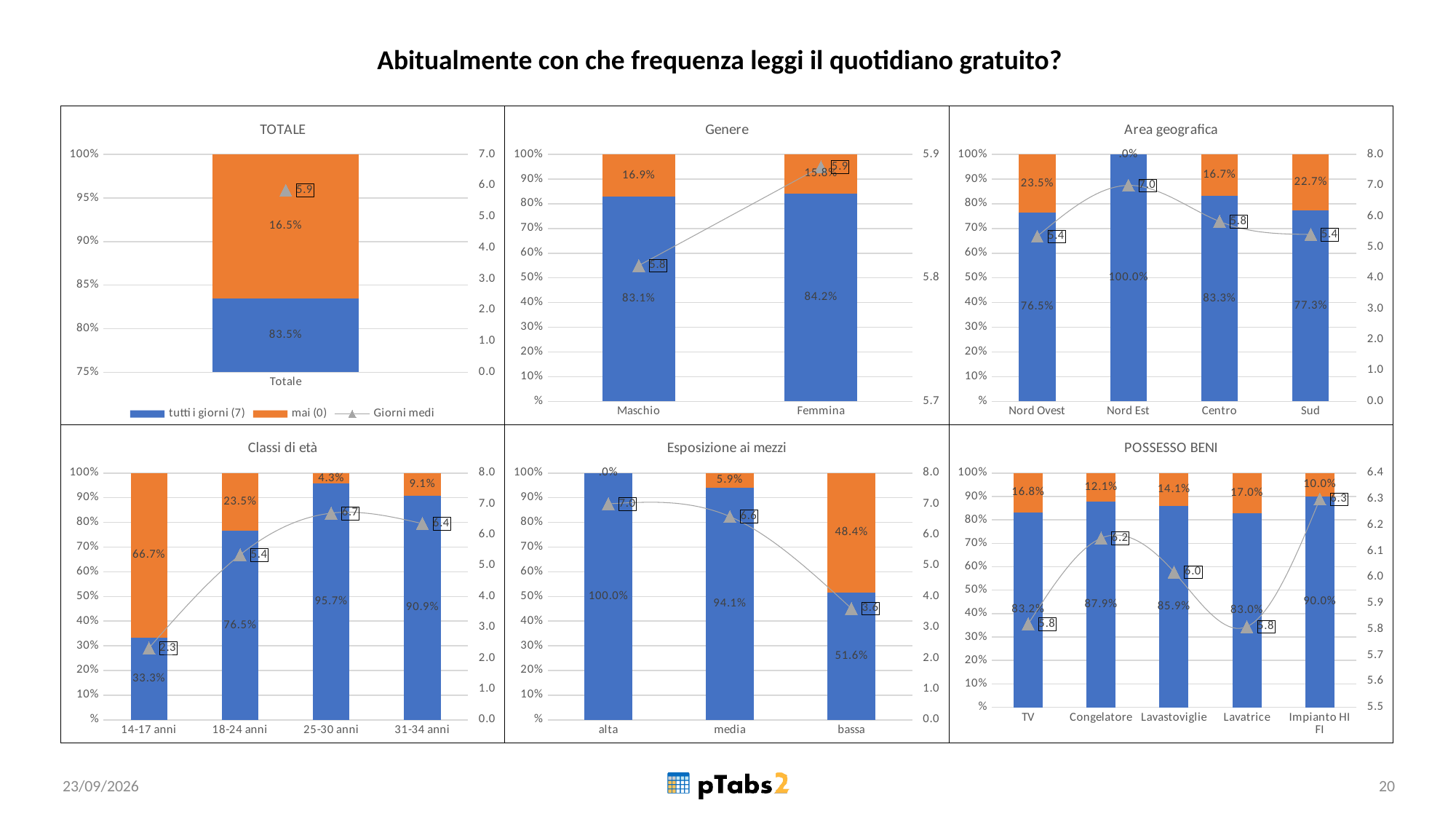
What kind of chart is the Area geografica chart? Stacked bar chart with a line In the Genere chart, what is the 'mai (0)' value for Maschio? 16.9% In the POSSESSO BENI chart, what is the 'Giorni medi' value for Congelatore? 6.2 In the Esposizione ai mezzi chart, which has a larger 'tutti i giorni (7)' value, media or bassa? media In the TOTALE chart, what is the value for 'tutti i giorni (7)'? 83.5% In the Esposizione ai mezzi chart, does the 'Giorni medi' line rise or fall from alta to bassa? fall In the Classi di età chart, which age class has the lowest 'tutti i giorni (7)' value? 14-17 anni How many categories are shown on the x axis of the POSSESSO BENI chart? 5 In the Area geografica chart, which area has the highest 'Giorni medi' value? Nord Est In the Classi di età chart, what is the difference between the 'mai (0)' values for 14-17 anni and 18-24 anni? 43.2% How many series does the legend of the TOTALE chart list? 3 In the Genere chart, what is the 'Giorni medi' value for Femmina? 5.9